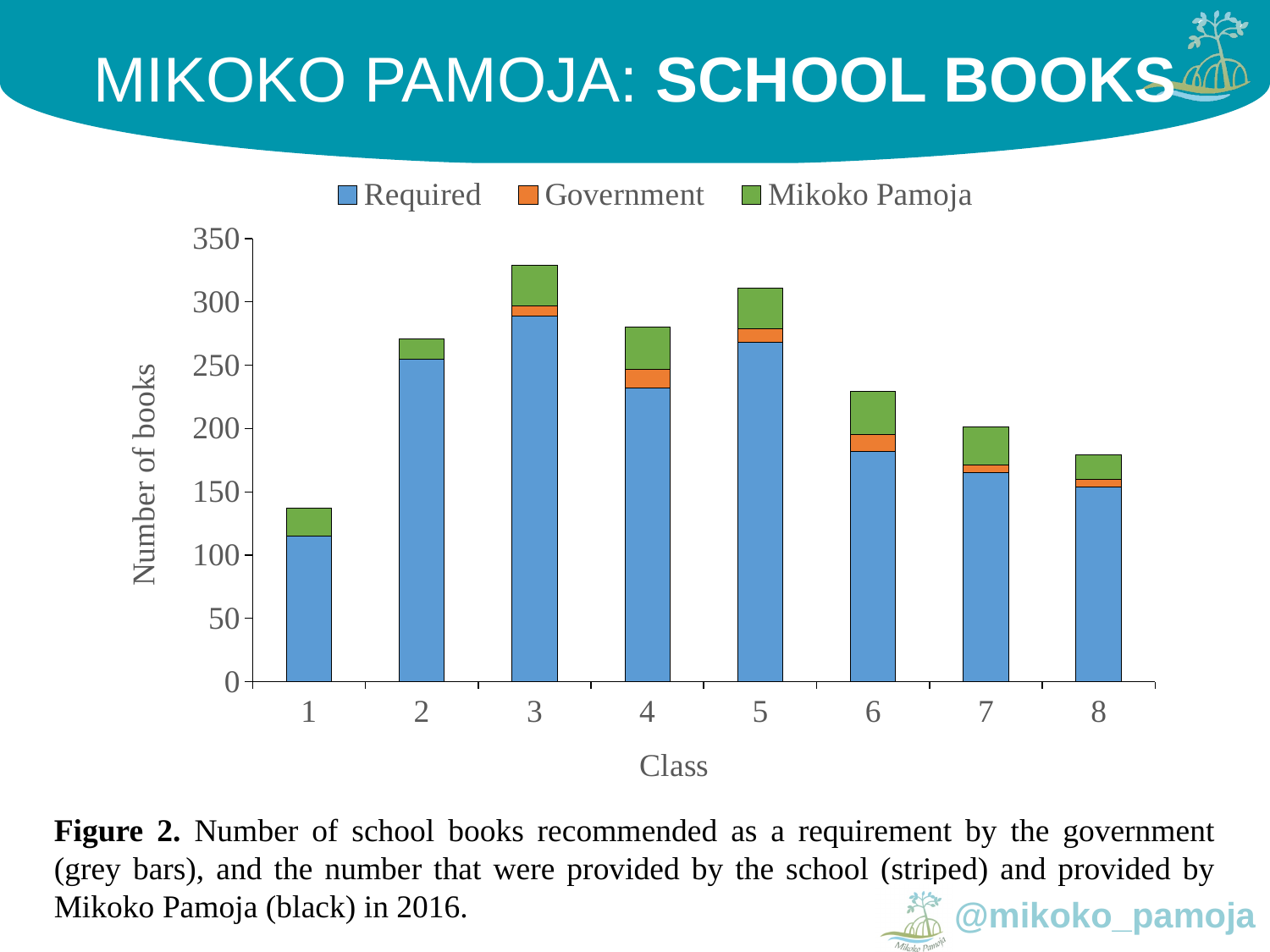
How many series does the chart's legend list? 3 Is the Required value for Class 4 greater or less than 200? greater What kind of chart is shown on the slide? Stacked bar chart Which class has the shortest stacked bar (lowest total number of books)? Class 1 Is the total number of books for Class 3 greater or less than 300? greater From Class 5 to Class 8, do the total numbers of books rise or fall? Fall How many classes are shown along the x axis of the chart? 8 Is the total number of books for Class 8 greater or less than 200? less What is the title of the chart's y axis? Number of books Which class has the tallest stacked bar (highest total number of books)? Class 3 Which has a larger total number of books, Class 2 or Class 6? Class 2